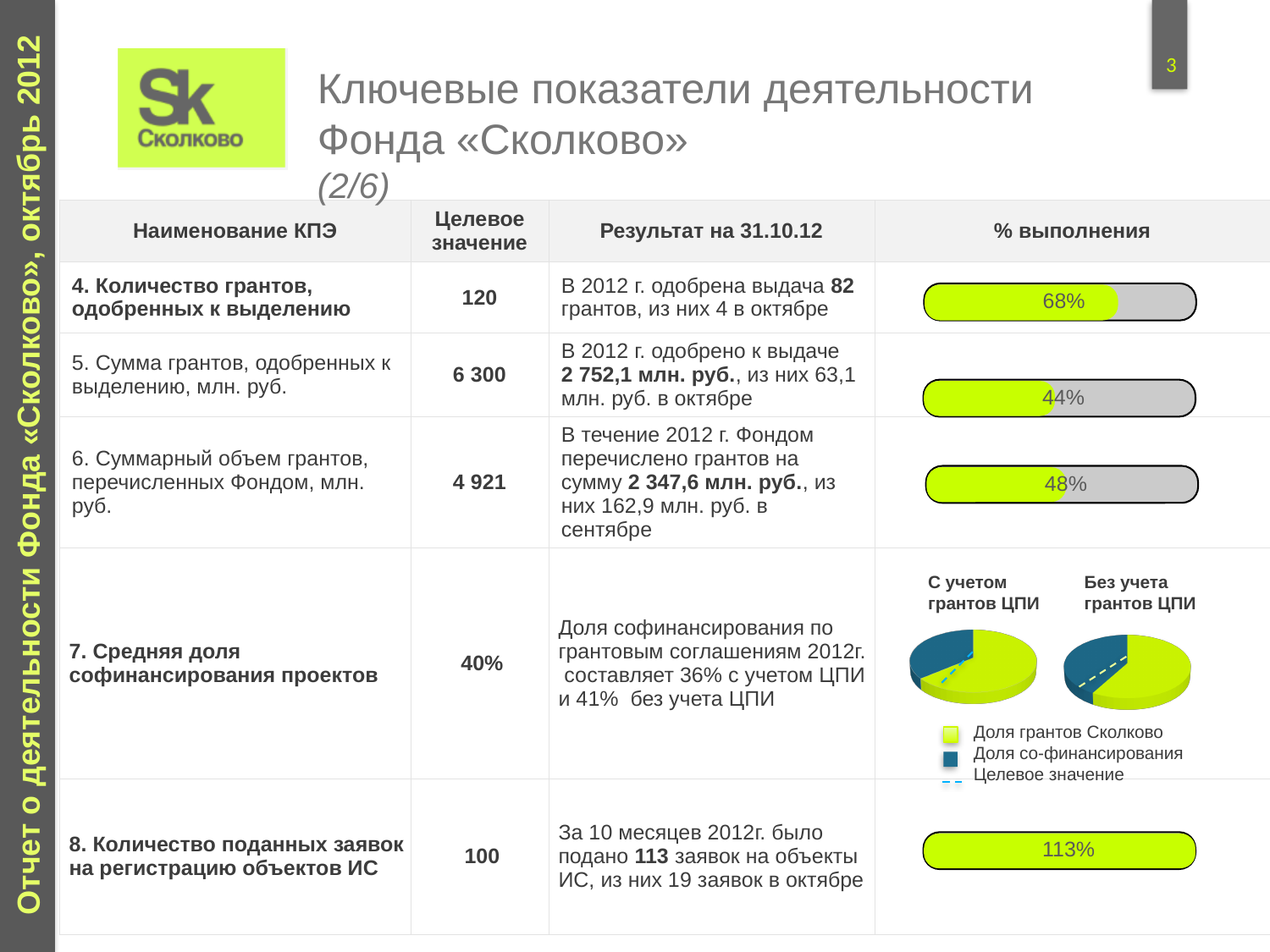
What percentage of completion is shown for KPI 8 (number of applications submitted for registration of IP objects)? 113% Is the completion percentage for KPI 8 greater or less than 100%? greater What is the difference in percentage points between the completion of KPI 4 (68%) and KPI 5 (44%)? 24 How many entries does the legend of the pie charts for KPI 7 list? 3 What percentage of completion is shown for KPI 6 (total volume of grants transferred by the Fund)? 48% What percentage of completion is shown for KPI 4 (number of grants approved for allocation)? 68% Which KPI has the lowest percentage of completion shown in the progress bars? 5. Сумма грантов, одобренных к выделению, млн. руб. Which is larger: the completion percentage for KPI 6 or for KPI 5? KPI 6 (48%) What type of chart is used in the '% выполнения' column for KPI 7 (average share of project co-financing)? Pie chart Which KPI has the highest percentage of completion shown in the progress bars? 8. Количество поданных заявок на регистрацию объектов ИС What percentage of completion is shown for KPI 5 (sum of grants approved for allocation)? 44% How many progress bars showing percentage of completion are on the slide? 4